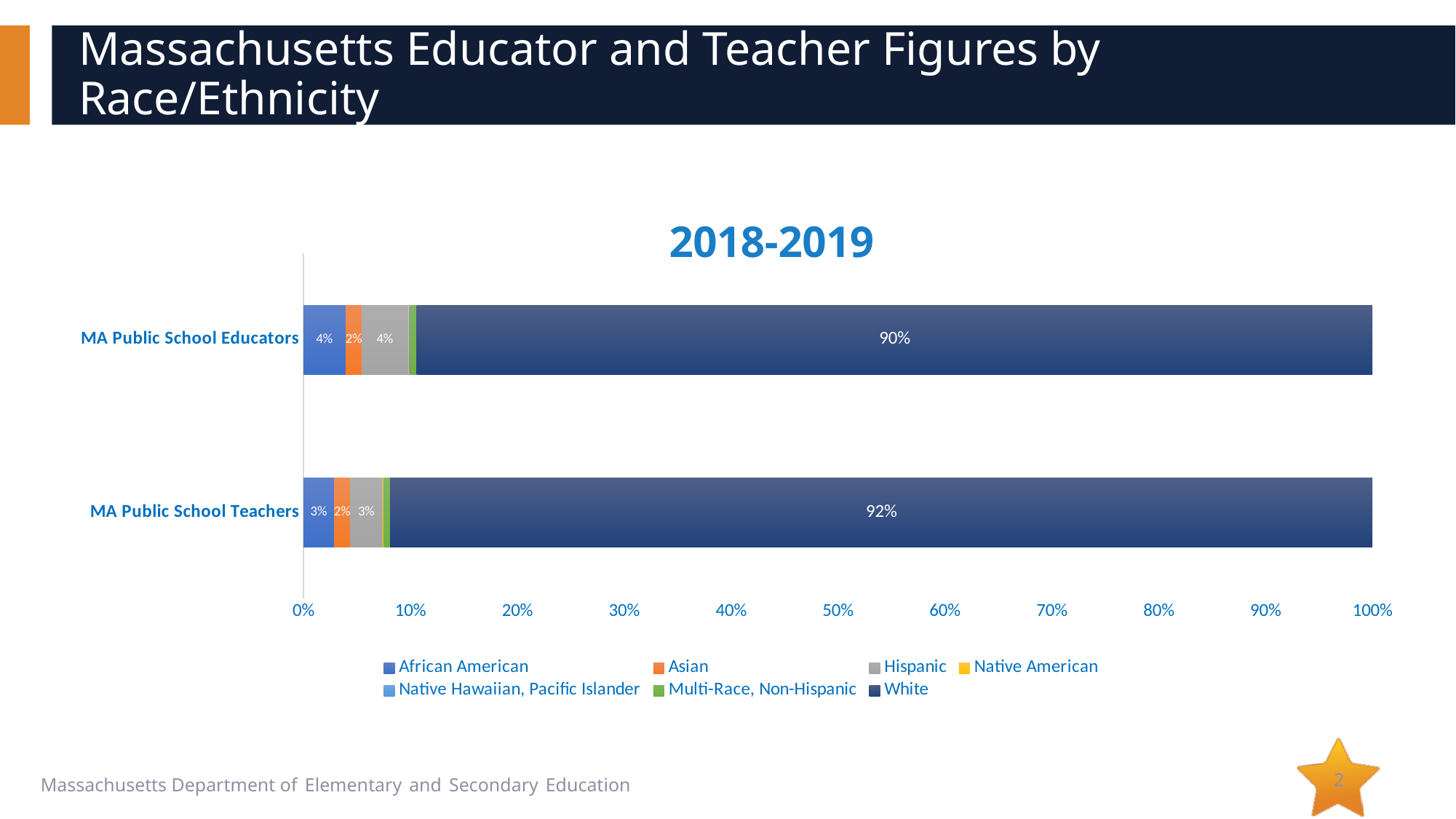
What is the African American share for MA Public School Educators? 4% What is the White share for MA Public School Educators? 90% What is the White share for MA Public School Teachers? 92% What kind of chart is shown on the slide? Stacked bar chart Which category has the larger White share, MA Public School Educators or MA Public School Teachers? MA Public School Teachers What is the difference between the White share for MA Public School Teachers and for MA Public School Educators? 2% What is the Hispanic share for MA Public School Teachers? 3% Is the White share for MA Public School Educators greater or less than 50%? greater What is the title of the chart? 2018-2019 How many categories are plotted on the chart? 2 How many series does the legend list? 7 What is the Asian share for MA Public School Teachers? 2%